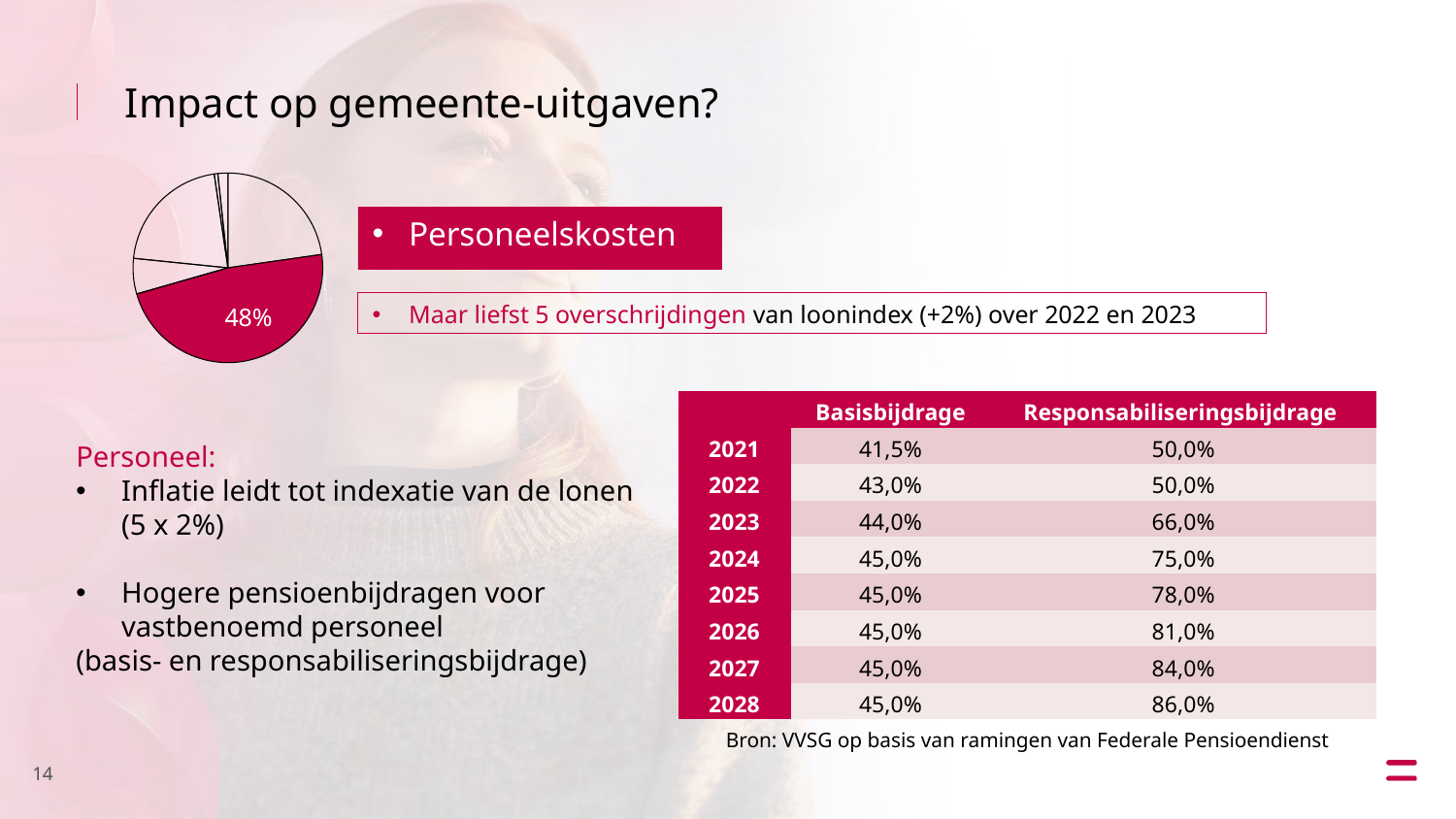
What value is printed on the highlighted (red) slice of the pie chart? 48% Which slice of the pie chart is the largest? the red slice labelled 48% How many slices in the pie chart carry a printed data label? 1 What kind of chart is shown at the top left of the slide? pie chart Is the share of the labelled slice in the pie chart greater or less than 50%? less What share of the pie does the red slice represent? 48% What colour is the slice labelled 48% in the pie chart? red Which cost category, shown in the box next to the pie chart, does the highlighted 48% slice refer to? Personeelskosten